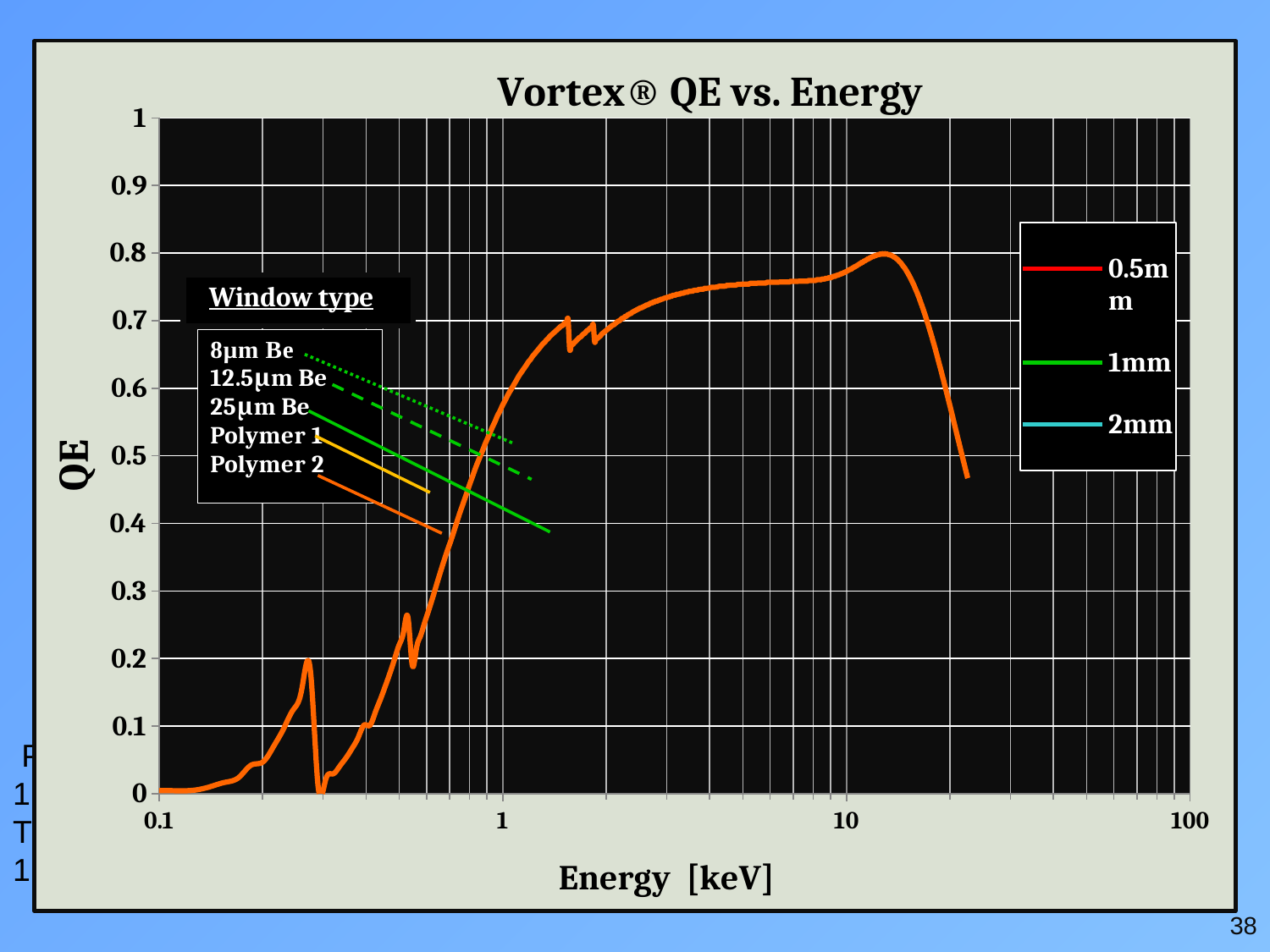
Is the peak QE value of the curve greater or less than 0.9? less What is the highest tick value shown on the x axis? 100 Does the QE curve rise or fall between 15 keV and 25 keV? fall What kind of chart is shown on the slide? line chart What is the label of the x axis? Energy [keV] Is the QE value at 0.1 keV greater or less than 0.1? less Is the QE value at 1 keV greater or less than 0.5? greater Does the QE curve rise or fall between 1 keV and 10 keV? rise How many series does the chart legend list? 3 What is the title of the chart? Vortex® QE vs. Energy